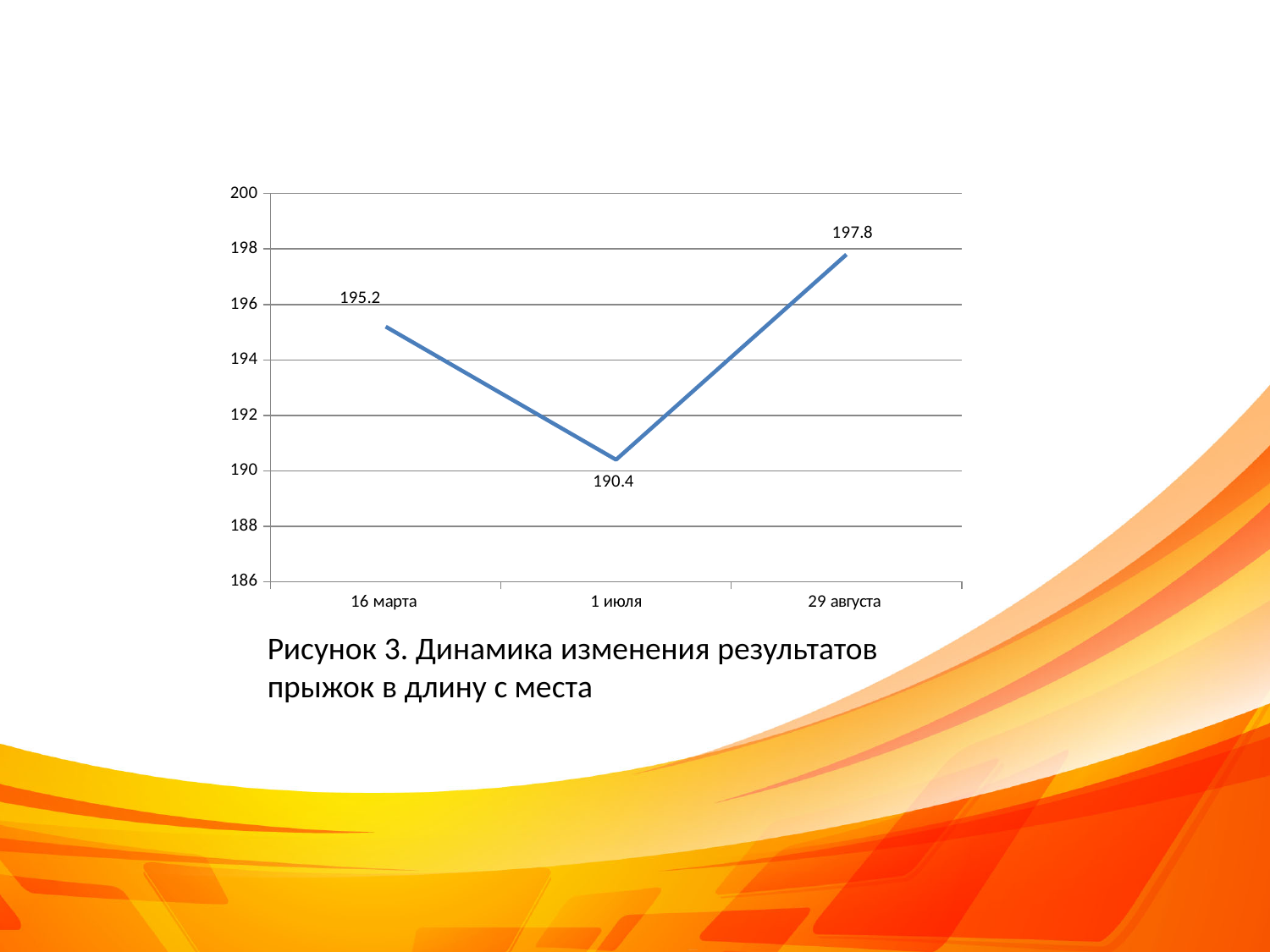
Is the value for 1 июля greater or less than 192? less Which date has the lowest value? 1 июля What is the difference between the values for 16 марта and 1 июля? 4.8 Which date has the highest value? 29 августа What is the difference between the values for 29 августа and 1 июля? 7.4 Does the value rise or fall from 1 июля to 29 августа? rise What kind of chart is shown on the slide? line chart What is the value for 29 августа? 197.8 Which is larger, the value for 16 марта or the value for 29 августа? 29 августа How many data points are plotted on the chart? 3 What is the value for 1 июля? 190.4 What is the value for 16 марта? 195.2